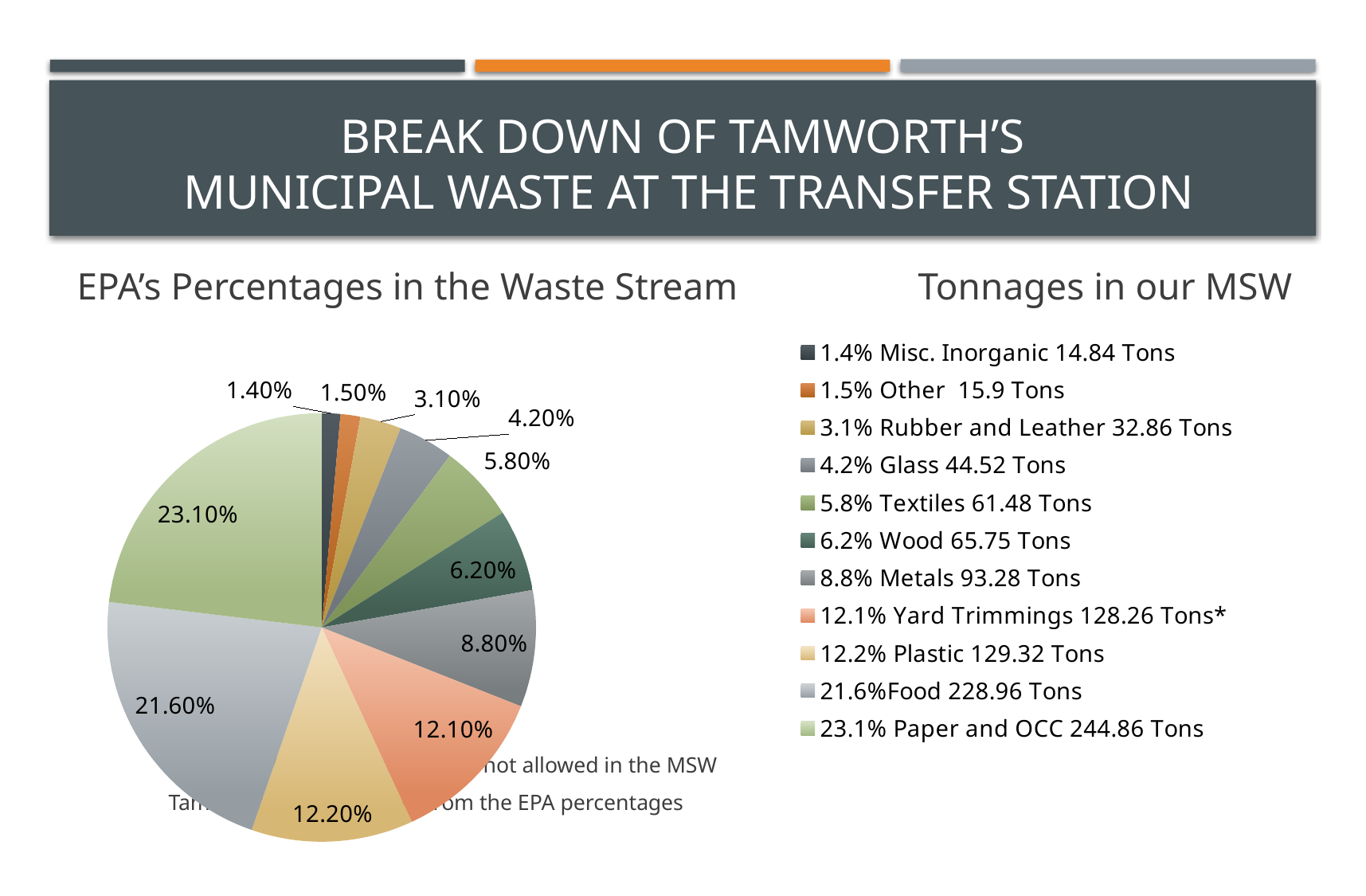
Which slice is larger, Food or Metals? Food Which category has the smallest share of the pie chart? Misc. Inorganic Which legend entry is marked with an asterisk? 12.1% Yard Trimmings 128.26 Tons* How many slices does the pie chart have? 11 What percentage of the pie chart is Food? 21.60% What percentage of the pie chart is Metals? 8.80% What kind of chart is shown on the slide? pie chart What percentage of the pie chart is Rubber and Leather? 3.10% Which category has the largest share of the pie chart? Paper and OCC According to the legend, how many tons of Glass are in the MSW? 44.52 Tons What is the difference in percentage points between the Paper and OCC slice and the Food slice? 1.50% What is the difference in percentage points between the Wood slice and the Textiles slice? 0.40%